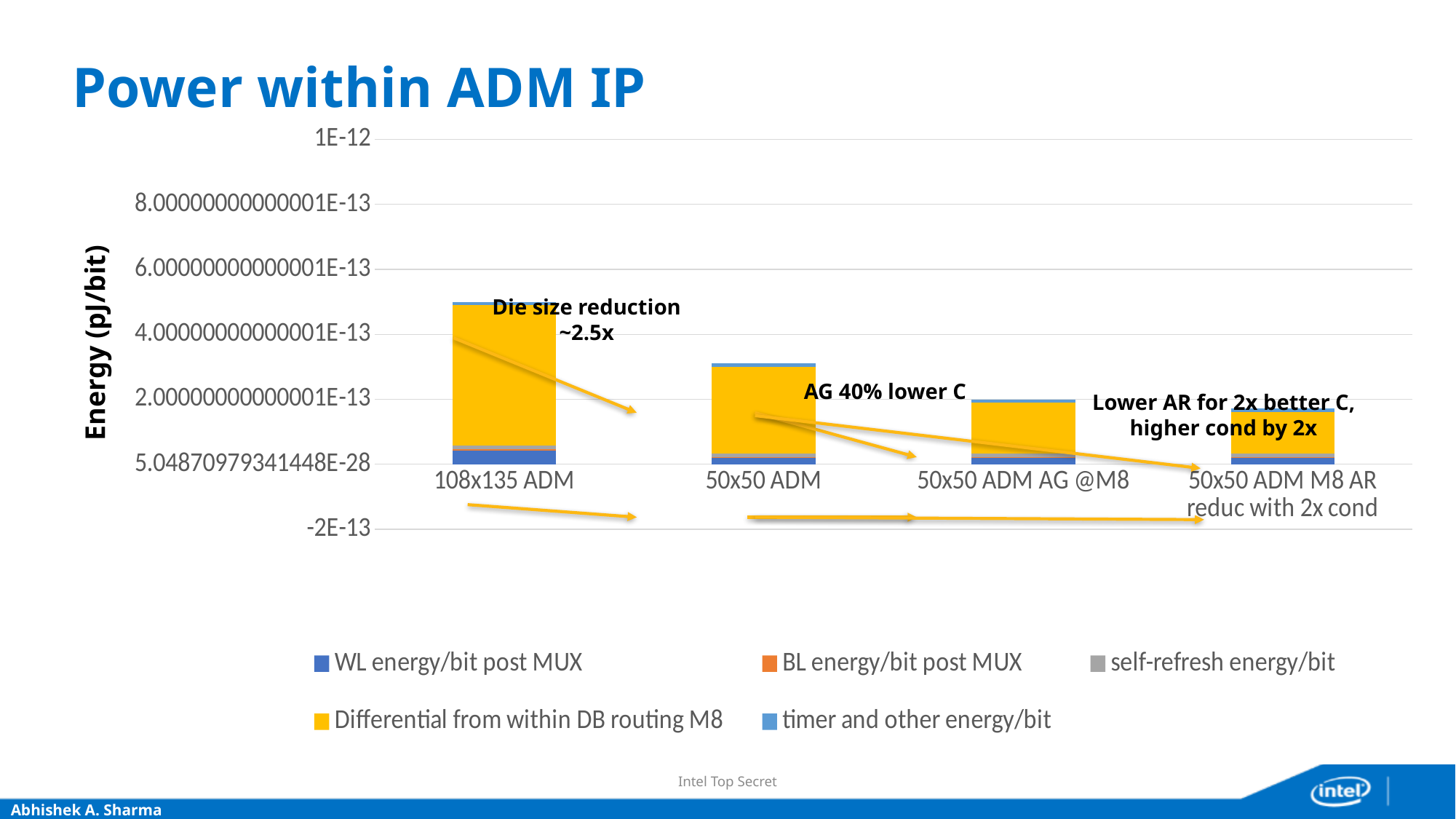
Which is larger, the stacked bar for 108x135 ADM or the stacked bar for 50x50 ADM? 108x135 ADM Which category has the tallest stacked bar? 108x135 ADM Is the total for 108x135 ADM greater or less than 4.00000000000001E-13? greater Which series is shown in yellow in the legend? Differential from within DB routing M8 Is the total for 50x50 ADM M8 AR reduc with 2x cond greater or less than 2.00000000000001E-13? less Which category has the shortest stacked bar? 50x50 ADM M8 AR reduc with 2x cond How many categories are plotted along the x axis? 4 Is the total for 50x50 ADM greater or less than 2.00000000000001E-13? greater What is the title of the chart? Power within ADM IP How many series does the legend list? 5 What kind of chart is shown on the slide? Stacked bar chart Do the stacked bar totals rise or fall from left to right along the x axis? Fall